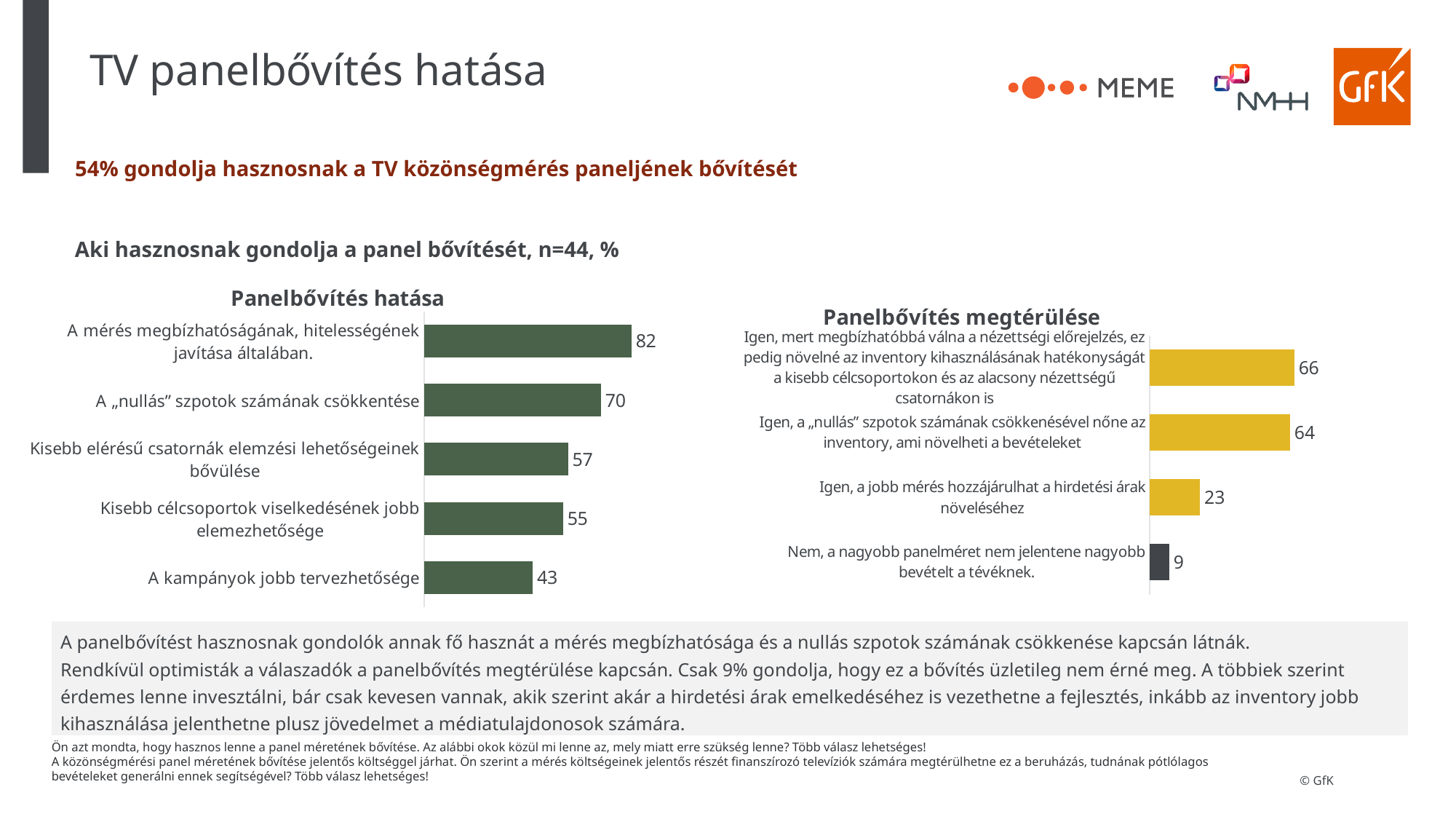
In the "Panelbővítés hatása" chart, what is the value for "A „nullás” szpotok számának csökkentése"? 70 In the "Panelbővítés megtérülése" chart, what is the difference between the values for "Igen, a „nullás” szpotok számának csökkenésével nőne az inventory, ami növelheti a bevételeket" and "Igen, a jobb mérés hozzájárulhat a hirdetési árak növeléséhez"? 41 In the "Panelbővítés hatása" chart, what is the value for "A kampányok jobb tervezhetősége"? 43 In the "Panelbővítés hatása" chart, which category has the lowest value? A kampányok jobb tervezhetősége In the "Panelbővítés hatása" chart, which category has the highest value? A mérés megbízhatóságának, hitelességének javítása általában. In the "Panelbővítés megtérülése" chart, what is the value for "Igen, a jobb mérés hozzájárulhat a hirdetési árak növeléséhez"? 23 In the "Panelbővítés megtérülése" chart, what is the value for "Nem, a nagyobb panelméret nem jelentene nagyobb bevételt a tévéknek."? 9 In the "Panelbővítés hatása" chart, what is the difference between the values for "A mérés megbízhatóságának, hitelességének javítása általában." and "A kampányok jobb tervezhetősége"? 39 In the "Panelbővítés megtérülése" chart, how many categories are shown? 4 What type of chart is the "Panelbővítés hatása" chart? Bar chart In the "Panelbővítés hatása" chart, how many categories are shown? 5 In the "Panelbővítés megtérülése" chart, which category has the lowest value? Nem, a nagyobb panelméret nem jelentene nagyobb bevételt a tévéknek.